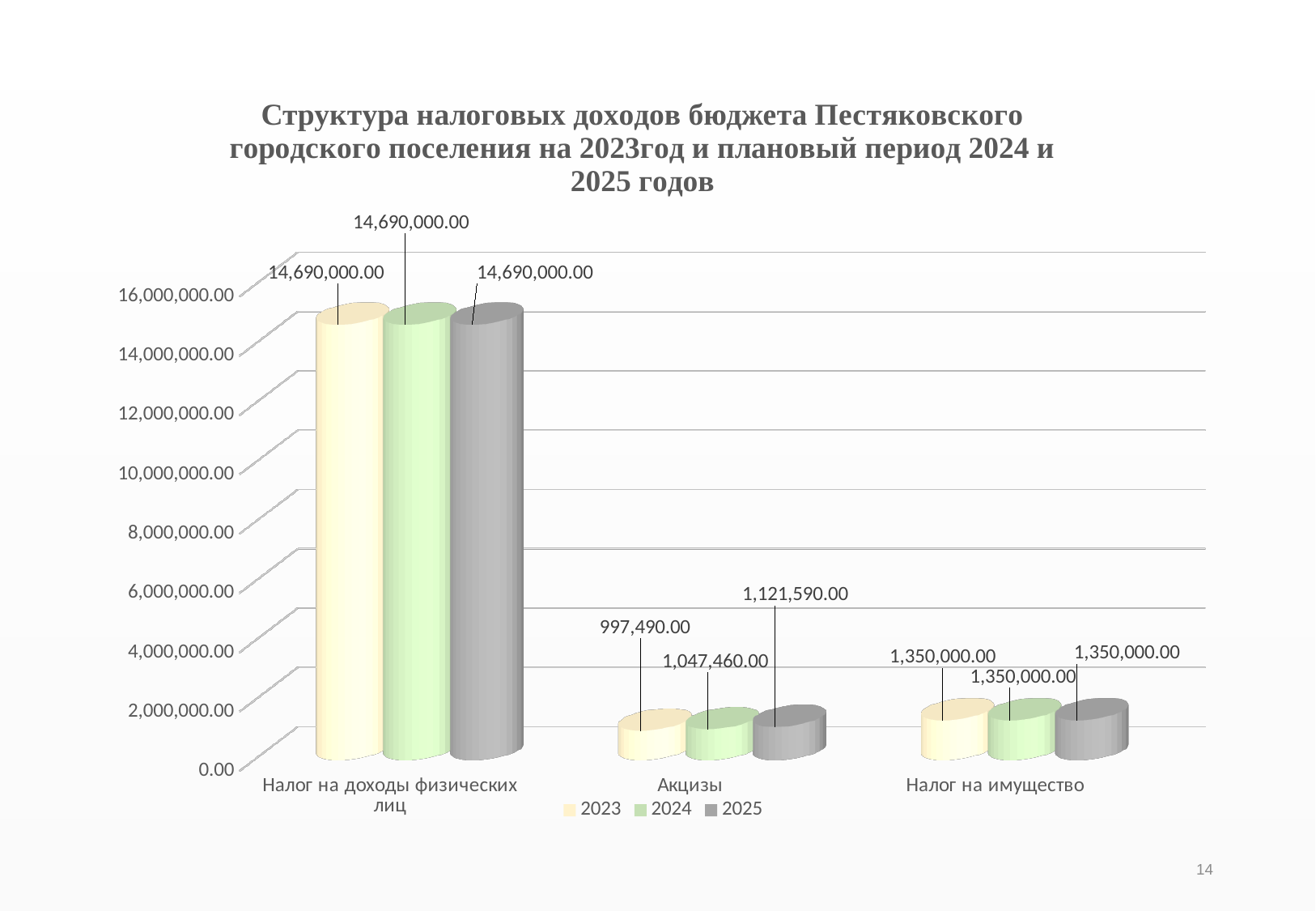
What is the value for Акцизы in the 2023 series? 997,490.00 How many series does the legend list? 3 What kind of chart is shown on the slide? Bar chart What is the value for Налог на имущество in the 2024 series? 1,350,000.00 Do the values for Акцизы rise or fall from 2023 to 2025? Rise What is the value for Акцизы in the 2025 series? 1,121,590.00 What is the difference between the 2025 and 2023 values for Акцизы? 124,100.00 How many categories are shown on the x axis? 3 Which is larger for Акцизы: the 2024 value or the 2025 value? 2025 Which category has the lowest value in the 2023 series? Акцизы What is the value for Налог на доходы физических лиц in the 2023 series? 14,690,000.00 Which category has the highest value in the 2024 series? Налог на доходы физических лиц